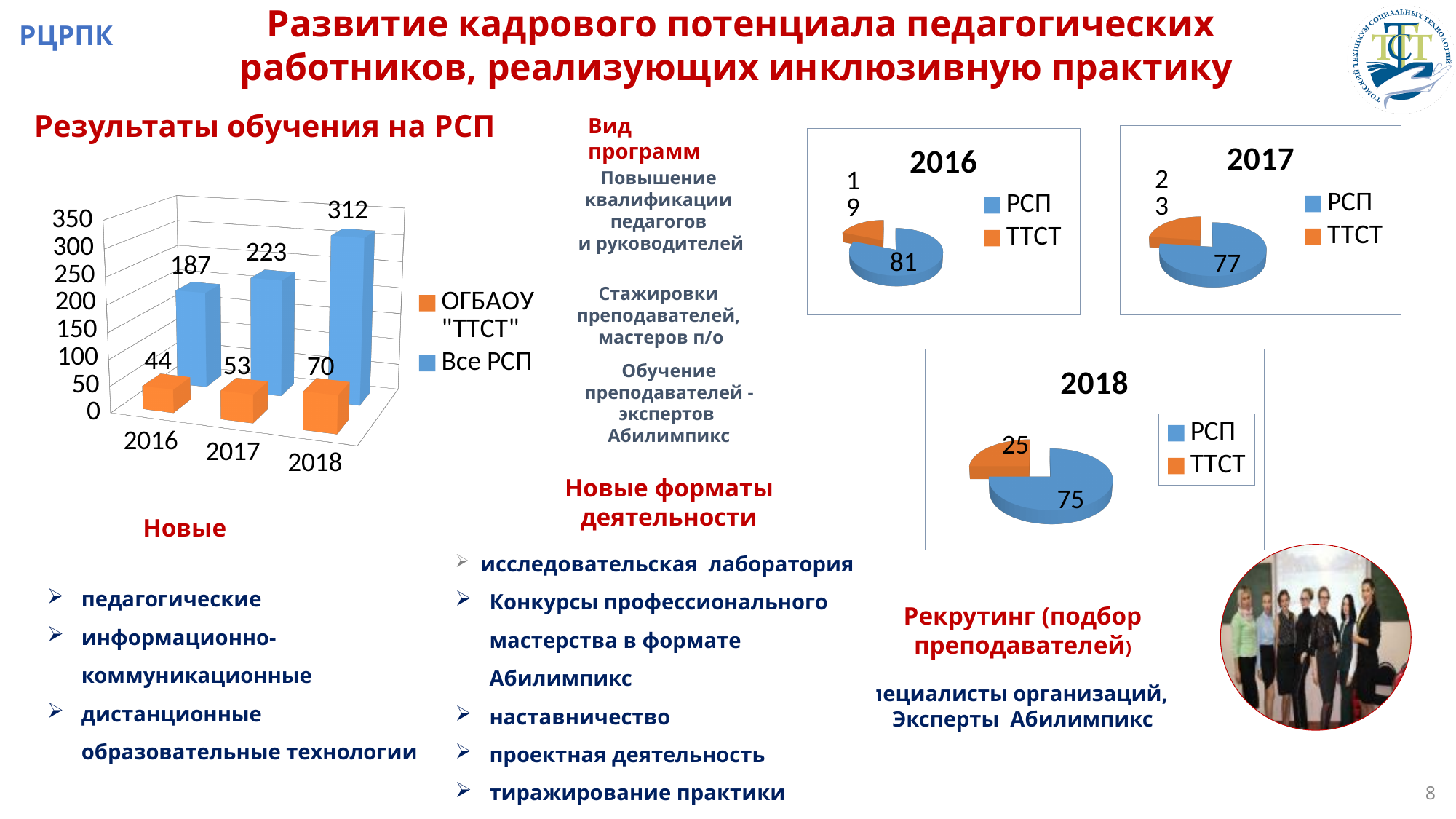
In the bar chart 'Результаты обучения на РСП', which year has the lowest value for 'ОГБАОУ "ТТСТ"'? 2016 In the bar chart 'Результаты обучения на РСП', what is the difference between the 'Все РСП' values for 2018 and 2016? 125 In the bar chart 'Результаты обучения на РСП', which year has the highest value for 'Все РСП'? 2018 In the '2018' pie chart, what is the value for 'ТТСТ'? 25 What kind of chart is the '2018' chart on the right side of the slide? pie chart In the bar chart 'Результаты обучения на РСП', what is the value for 'Все РСП' in 2018? 312 In the bar chart 'Результаты обучения на РСП', what is the value for 'Все РСП' in 2017? 223 How many years are shown on the x axis of the bar chart 'Результаты обучения на РСП'? 3 How many series does the legend of the bar chart 'Результаты обучения на РСП' list? 2 In the bar chart 'Результаты обучения на РСП', what is the value for 'ОГБАОУ "ТТСТ"' in 2016? 44 In the bar chart 'Результаты обучения на РСП', do the 'Все РСП' values rise or fall from 2016 to 2018? rise In the '2016' pie chart, what is the value for 'РСП'? 81